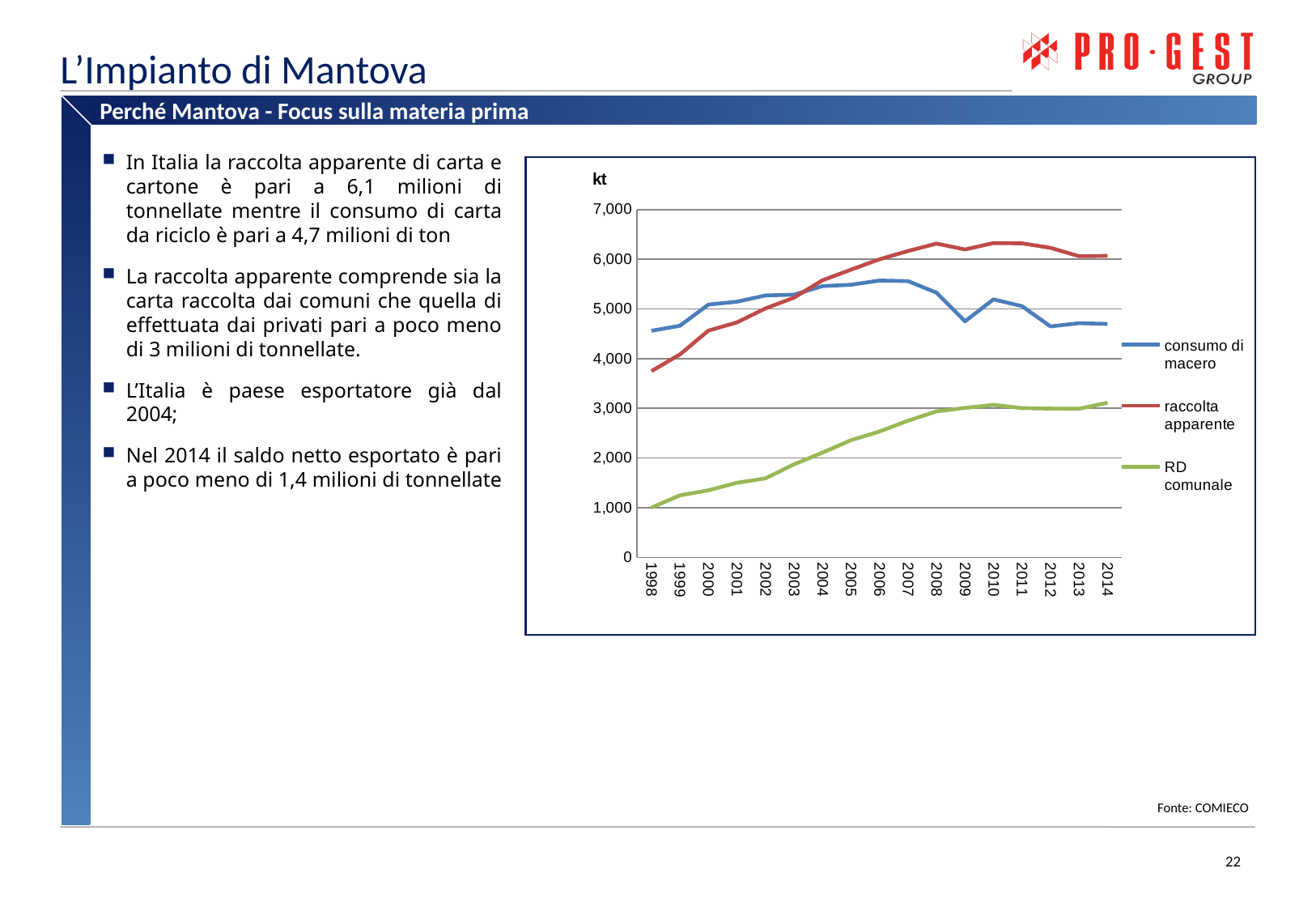
In 2014, which series has the higher value: raccolta apparente or consumo di macero? raccolta apparente How many years are plotted along the x axis of the chart? 17 What kind of chart is shown on the slide? line chart Is the value for consumo di macero in 2009 greater or less than 5,000? less Does the RD comunale series generally rise or fall from 1998 to 2014? rise In 1998, which series has the higher value: consumo di macero or raccolta apparente? consumo di macero Is the value for raccolta apparente in 2008 greater or less than 6,000? greater Is the value for RD comunale in 2002 greater or less than 2,000? less How many series does the chart legend list? 3 Which series has the lowest values across all years in the chart? RD comunale What unit label is shown at the top of the chart's y axis? kt